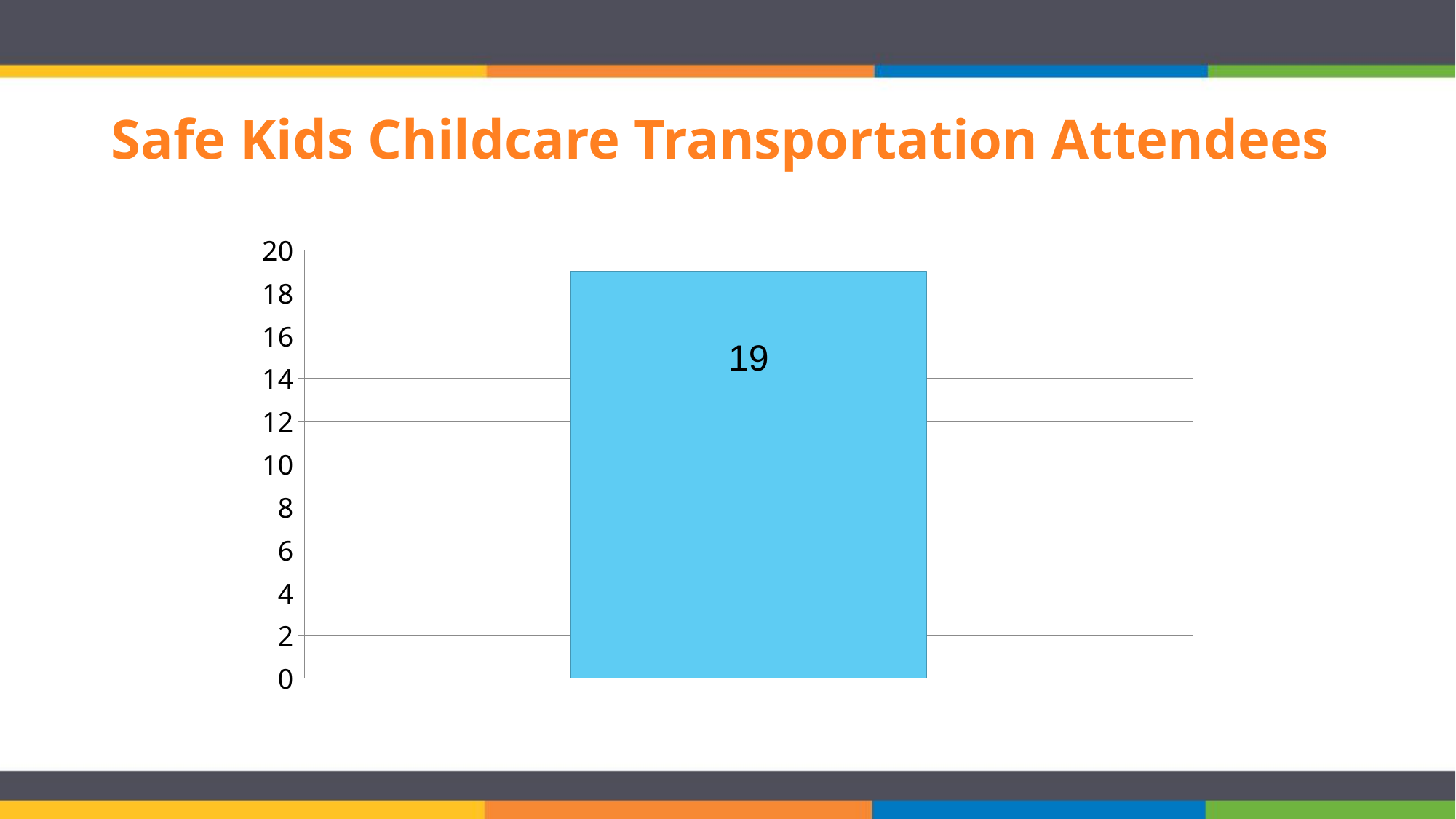
Is the value of the bar greater or less than 20? less What value is shown on the single bar in the chart? 19 What is the title of the slide containing the chart? Safe Kids Childcare Transportation Attendees What kind of chart is shown on the slide? bar chart What is the maximum value shown on the vertical axis? 20 How many bars are plotted in the chart? 1 Is the value of the bar greater or less than 10? greater